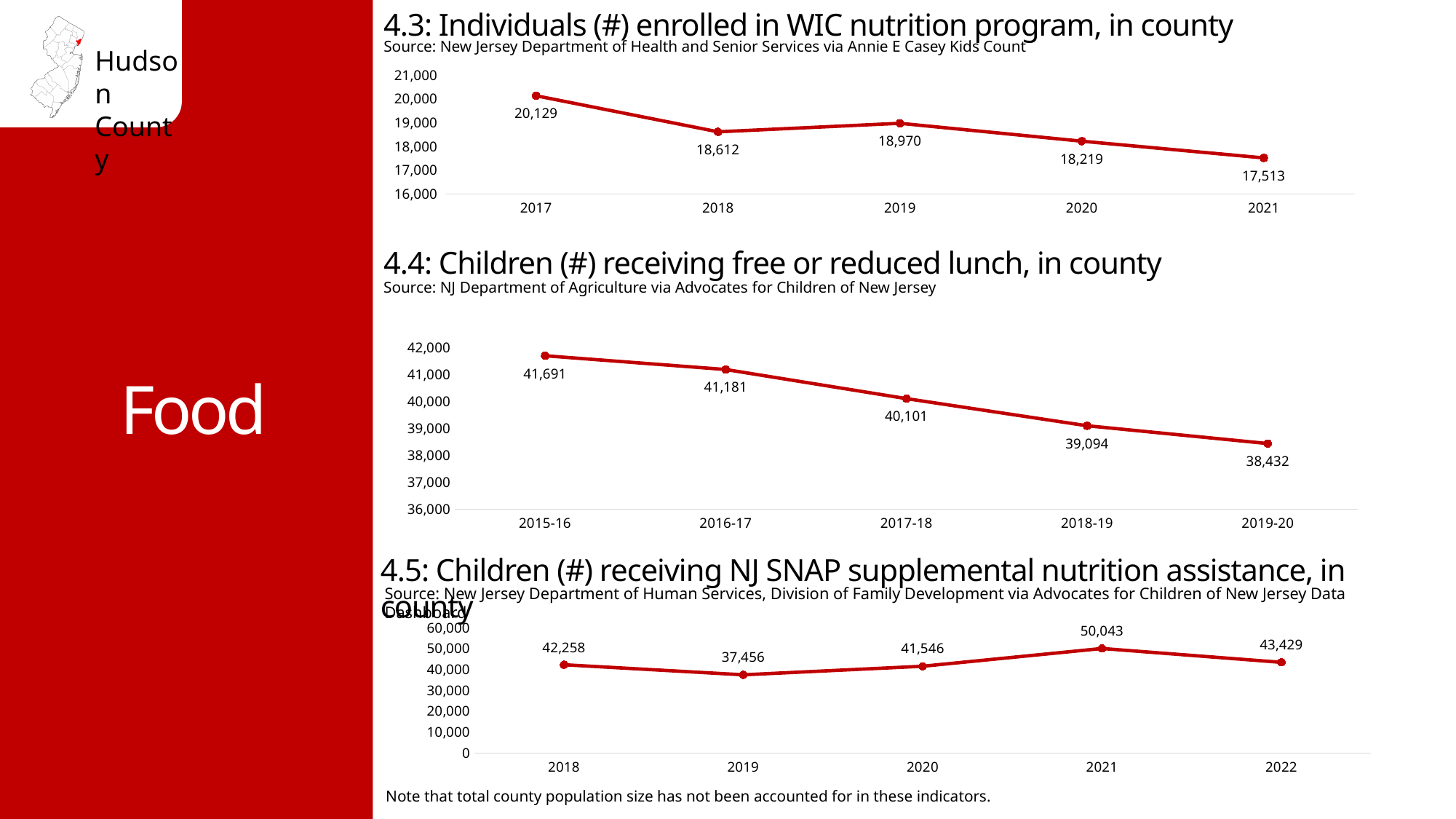
In the chart '4.5: Children (#) receiving NJ SNAP supplemental nutrition assistance, in county', what is the difference between the 2021 and 2020 values? 8,497 In the chart '4.3: Individuals (#) enrolled in WIC nutrition program, in county', which year has the highest value? 2017 In the chart '4.3: Individuals (#) enrolled in WIC nutrition program, in county', what is the difference between the 2017 and 2021 values? 2,616 In the chart '4.5: Children (#) receiving NJ SNAP supplemental nutrition assistance, in county', which year has the lowest value? 2019 In the chart '4.5: Children (#) receiving NJ SNAP supplemental nutrition assistance, in county', which is larger, the value for 2018 or the value for 2022? 2022 In the chart '4.3: Individuals (#) enrolled in WIC nutrition program, in county', what is the value for 2019? 18,970 In the chart '4.4: Children (#) receiving free or reduced lunch, in county', which school year has the lowest value? 2019-20 In the chart '4.5: Children (#) receiving NJ SNAP supplemental nutrition assistance, in county', what is the value for 2021? 50,043 In the chart '4.4: Children (#) receiving free or reduced lunch, in county', what is the value for 2017-18? 40,101 In the chart '4.4: Children (#) receiving free or reduced lunch, in county', do the values rise or fall from 2015-16 to 2019-20? fall In the chart '4.3: Individuals (#) enrolled in WIC nutrition program, in county', how many years are plotted? 5 What kind of chart is '4.4: Children (#) receiving free or reduced lunch, in county'? line chart